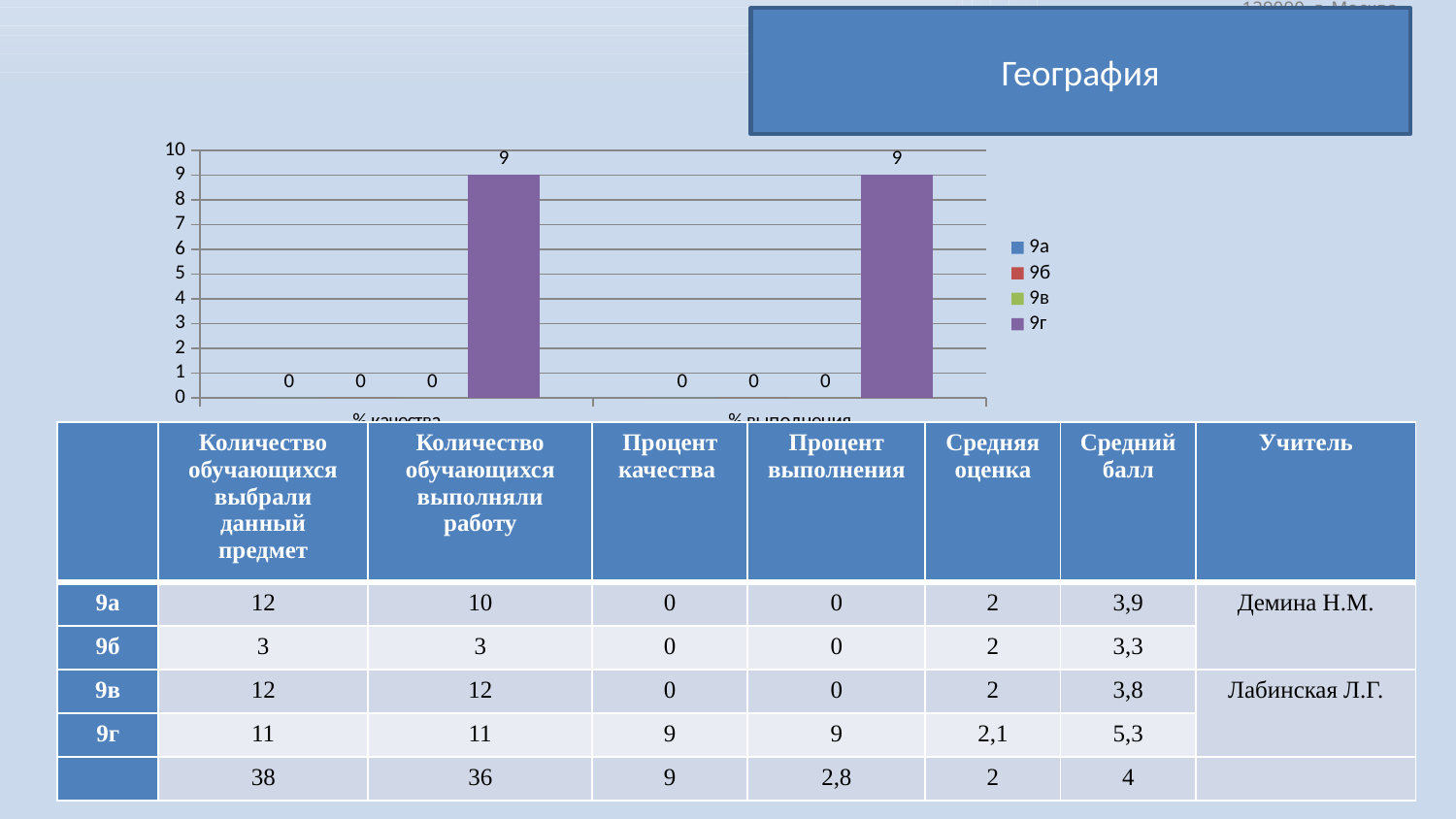
How many category groups are shown along the x axis of the chart? 2 What kind of chart is shown on the slide? bar chart Is the value for 9г in the left category group greater or less than 5? greater What is the difference between the values for 9г and 9в in the left category group? 9 In the right category group, which is larger: the value for 9г or the value for 9б? 9г What is the value for 9г in the left category group (% качества)? 9 Which series has the highest value in the right category group (% выполнения)? 9г What is the value for 9а in the left category group (% качества)? 0 What are the series listed in the chart legend? 9а, 9б, 9в, 9г How many series does the chart legend list? 4 What colour are the bars for series 9г? purple What is the value for 9в in the right category group (% выполнения)? 0